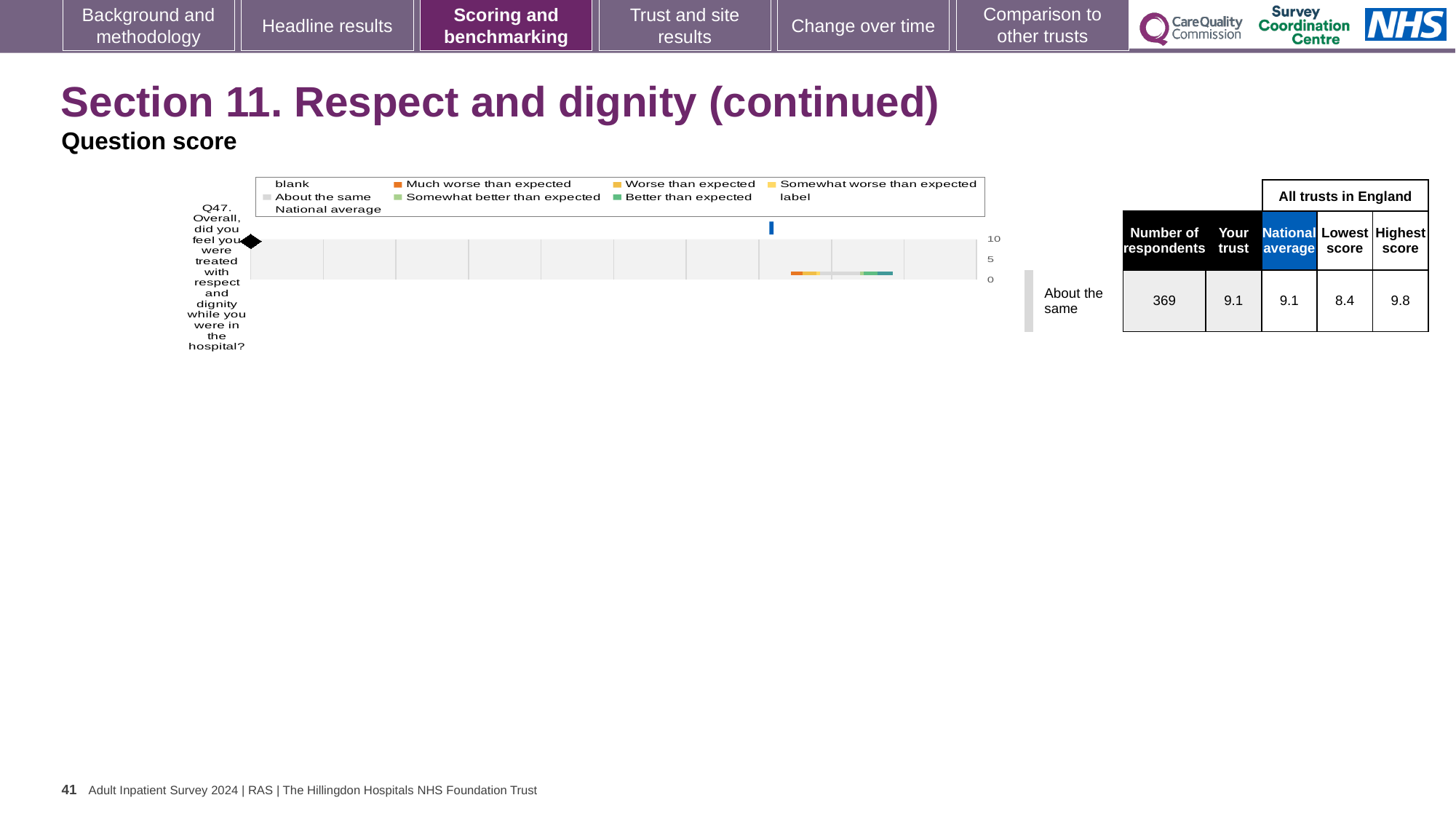
Which benchmarking category is Q47 placed in? About the same How many questions are plotted on the chart? 1 What is the difference between the highest and lowest scores for Q47 across all trusts in England? 1.4 What is the national average score for Q47? 9.1 What is the highest score among all trusts in England for Q47? 9.8 Is the 'Your trust' score for Q47 higher than, lower than, or the same as the national average? the same What is the lowest score among all trusts in England for Q47? 8.4 How many respondents answered Q47? 369 What is the highest value shown on the chart's axis? 10 What is the 'Your trust' score for Q47? 9.1 Is the national average marker for Q47 greater or less than 5 on the axis? greater What kind of chart is used to show the Q47 question score? bar chart